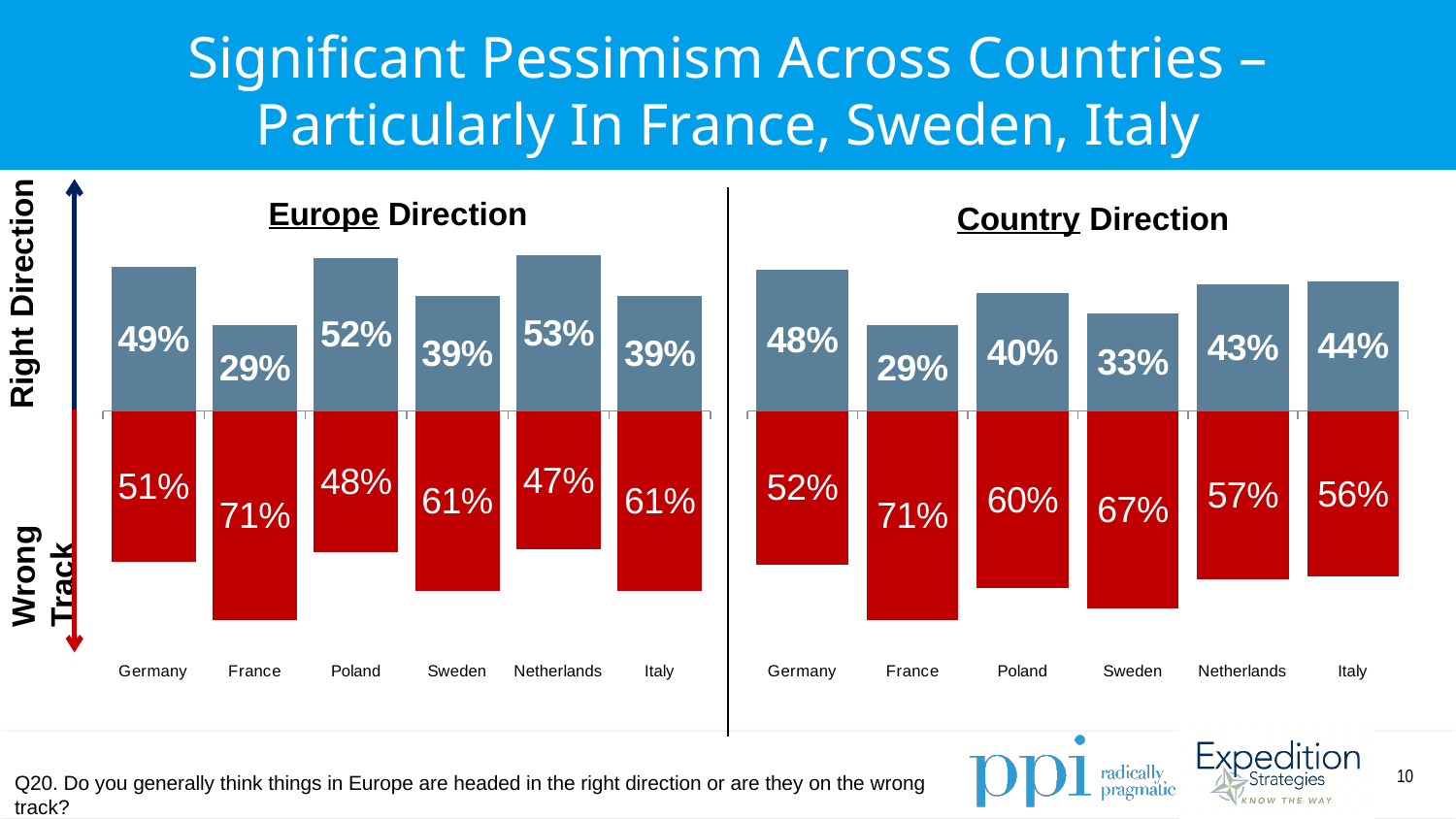
In the Country Direction chart, which country has the lowest Right Direction value? France How many countries are shown in the Europe Direction chart? 6 In the Country Direction chart, what is the Wrong Track value for Sweden? 67% In the Country Direction chart, what is the difference between the Wrong Track values for Sweden and Germany? 15 percentage points What type of chart is used for the Country Direction data? Bar chart In the Europe Direction chart, what is the difference between the Wrong Track and Right Direction values for France? 42 percentage points In the Europe Direction chart, which country has the highest Right Direction value? Netherlands In the Europe Direction chart, what is the Wrong Track value for Sweden? 61% In the Country Direction chart, which country has the highest Wrong Track value? France Is the Right Direction value for Poland larger in the Europe Direction chart or the Country Direction chart? Europe Direction In the Europe Direction chart, what percentage of respondents in France say Europe is headed in the right direction? 29% In the Country Direction chart, what is the Right Direction value for Italy? 44%